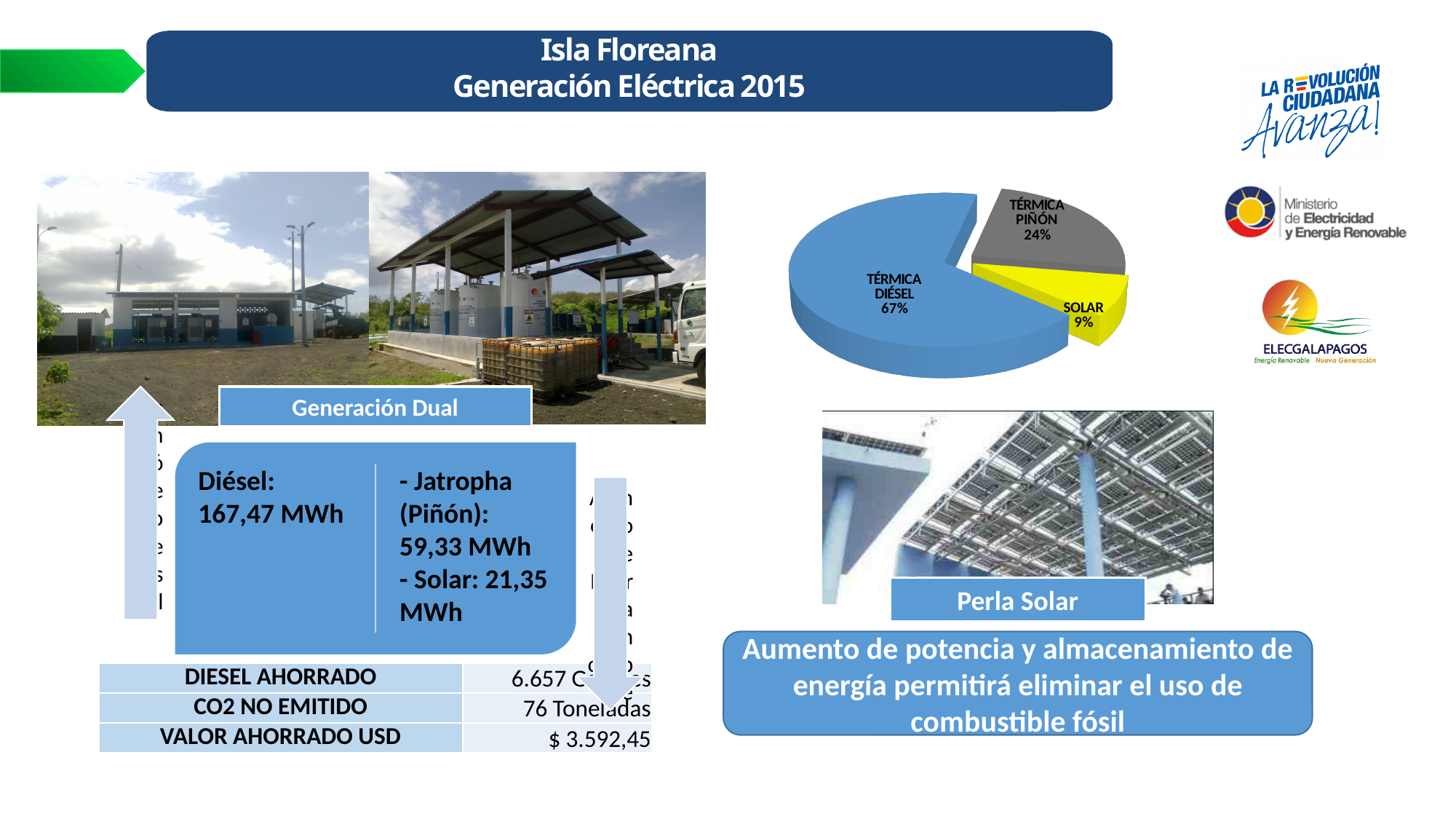
What is the difference in percentage points between TÉRMICA DIÉSEL and TÉRMICA PIÑÓN? 43 What share of the pie does SOLAR represent? 9% What is the difference in percentage points between TÉRMICA PIÑÓN and SOLAR? 15 What colour is the SOLAR slice of the pie chart? Yellow Which is larger in the pie chart, TÉRMICA PIÑÓN or SOLAR? TÉRMICA PIÑÓN How many slices does the pie chart have? 3 What colour is the TÉRMICA DIÉSEL slice of the pie chart? Blue Which slice of the pie chart is the smallest? SOLAR What share of the pie does TÉRMICA DIÉSEL represent? 67% Which slice of the pie chart is the largest? TÉRMICA DIÉSEL What share of the pie does TÉRMICA PIÑÓN represent? 24% What kind of chart is shown on the slide? Pie chart